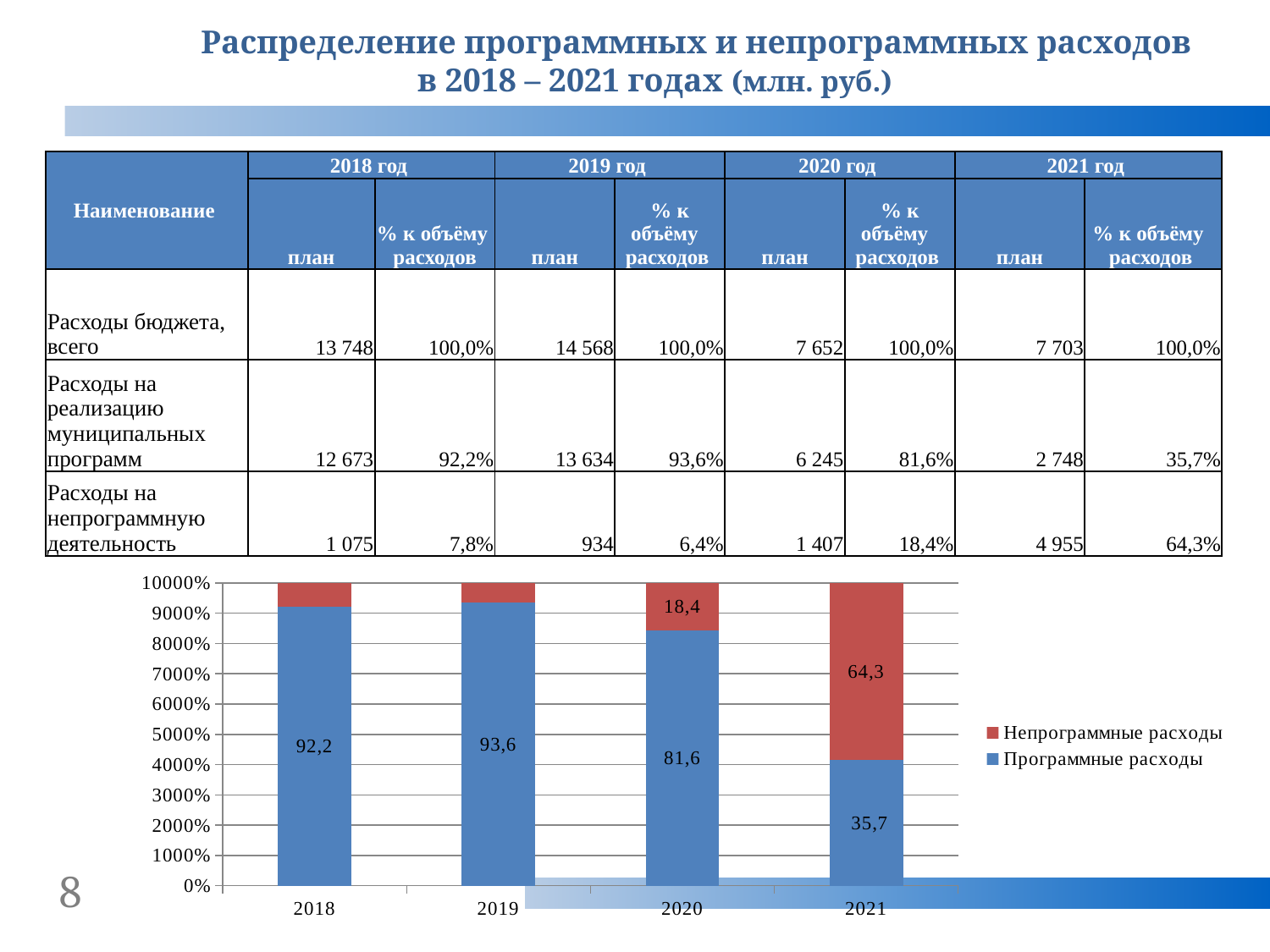
What is the value labelled for Программные расходы in 2019 on the chart? 93,6 What is the value labelled for Непрограммные расходы in 2020 on the chart? 18,4 What is the difference between the Программные расходы values for 2019 and 2021 on the chart? 57,9 In which year is the Программные расходы value the lowest on the chart? 2021 What is the value labelled for Непрограммные расходы in 2021 on the chart? 64,3 Which series is shown in red on the chart? Непрограммные расходы What is the value labelled for Программные расходы in 2020 on the chart? 81,6 What type of chart is shown on the slide? stacked bar chart In which year is the Программные расходы value the highest on the chart? 2019 How many series does the chart legend list? 2 What is the value labelled for Программные расходы in 2018 on the chart? 92,2 How many years (categories) are shown on the x axis of the chart? 4